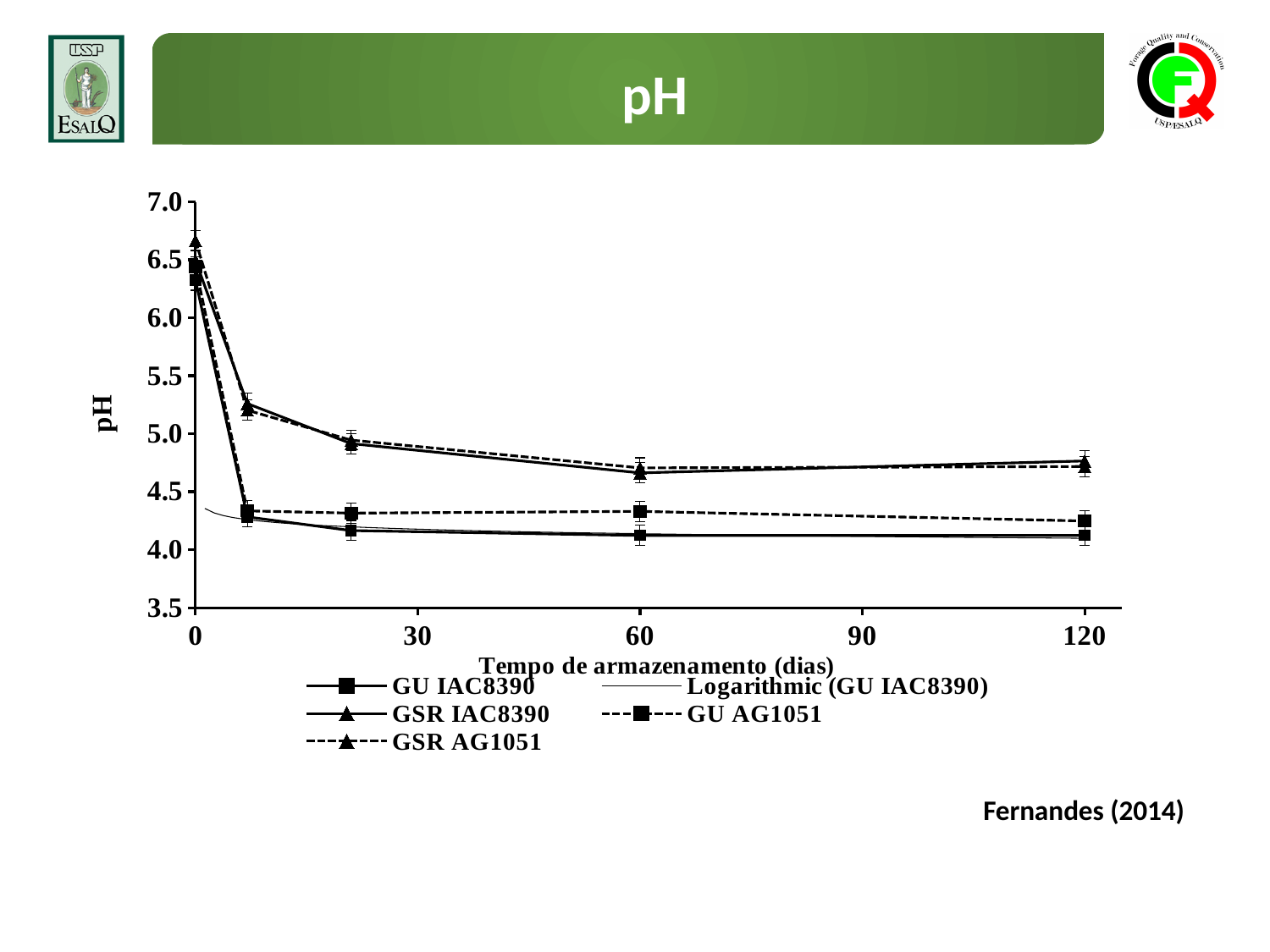
Is the pH of GSR IAC8390 at day 0 greater or less than 6.0? greater At 120 days, which has the higher pH: GSR IAC8390 or GU IAC8390? GSR IAC8390 Which series has the highest pH at day 0? GSR AG1051 What kind of chart is shown on the slide? line chart How many time points are plotted for the GU IAC8390 series? 5 Is the pH of GU IAC8390 at 120 days greater or less than 4.5? less How many series does the legend list? 5 What is the label of the x axis? Tempo de armazenamento (dias) Does the pH of GU IAC8390 rise or fall as storage time increases? fall Is the pH of GSR AG1051 at 60 days greater or less than 4.5? greater What is the title of the chart? pH